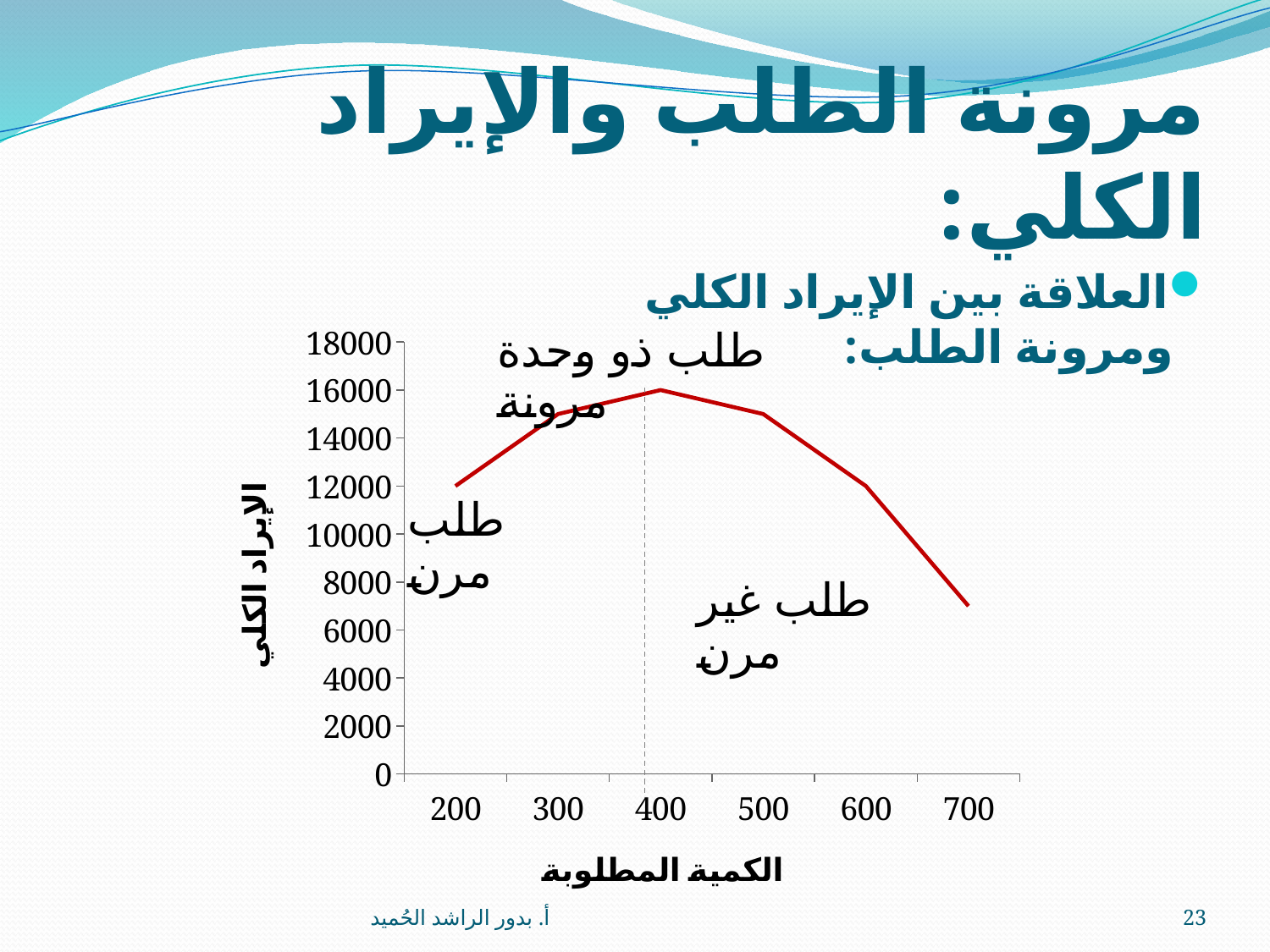
How many quantity values are labelled on the x axis? 6 What is the total revenue when the quantity demanded is 200? 12000 What is the title of the x axis of the chart? الكمية المطلوبة Which has higher total revenue: quantity 200 or quantity 700? 200 What is the total revenue (الإيراد الكلي) when the quantity demanded is 400? 16000 Is the total revenue at quantity 500 greater or less than 14000? greater What kind of chart is shown on the slide? line chart What is the difference between total revenue at quantity 400 and at quantity 200? 4000 Is the total revenue at quantity 700 greater or less than 8000? less At which quantity demanded is total revenue highest? 400 At which quantity demanded is total revenue lowest? 700 What is the total revenue when the quantity demanded is 600? 12000